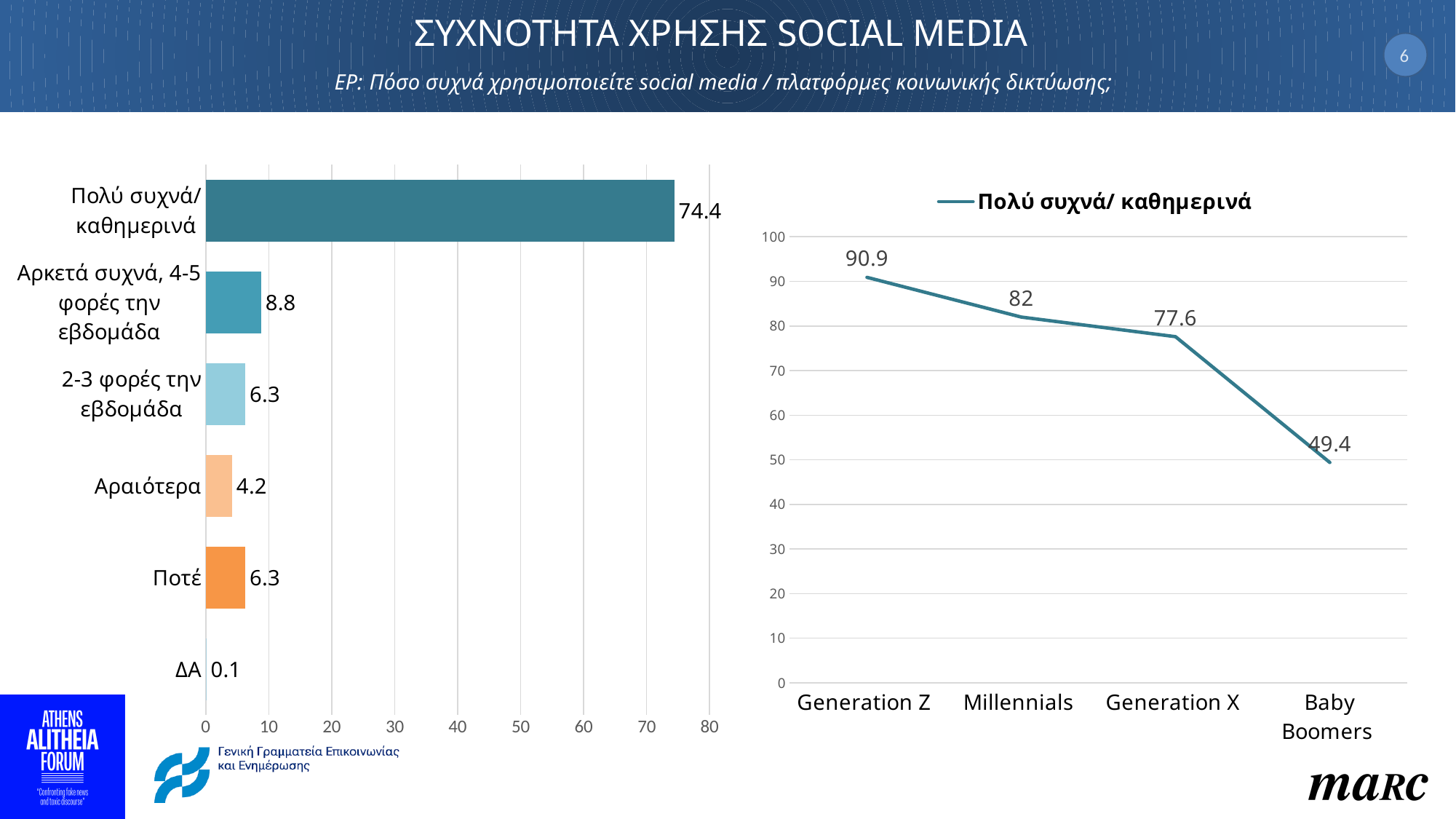
In the line chart on the right, what series name does the legend show? Πολύ συχνά/ καθημερινά In the bar chart on the left, what is the value for 'Πολύ συχνά/ καθημερινά'? 74.4 In the bar chart on the left, what is the value for 'Αραιότερα'? 4.2 In the line chart on the right, what is the difference between Generation Z and Generation X? 13.3 In the bar chart on the left, which category has the highest value? Πολύ συχνά/ καθημερινά In the bar chart on the left, which category has the lowest value? ΔΑ In the bar chart on the left, what is the difference between 'Αρκετά συχνά, 4-5 φορές την εβδομάδα' and '2-3 φορές την εβδομάδα'? 2.5 In the line chart on the right, what is the value for Baby Boomers? 49.4 In the line chart on the right, what is the value for Millennials? 82 What kind of chart is on the left side of the slide? Bar chart In the bar chart on the left, how many categories are shown? 6 In the line chart on the right, do the values rise or fall from Generation Z to Baby Boomers? Fall